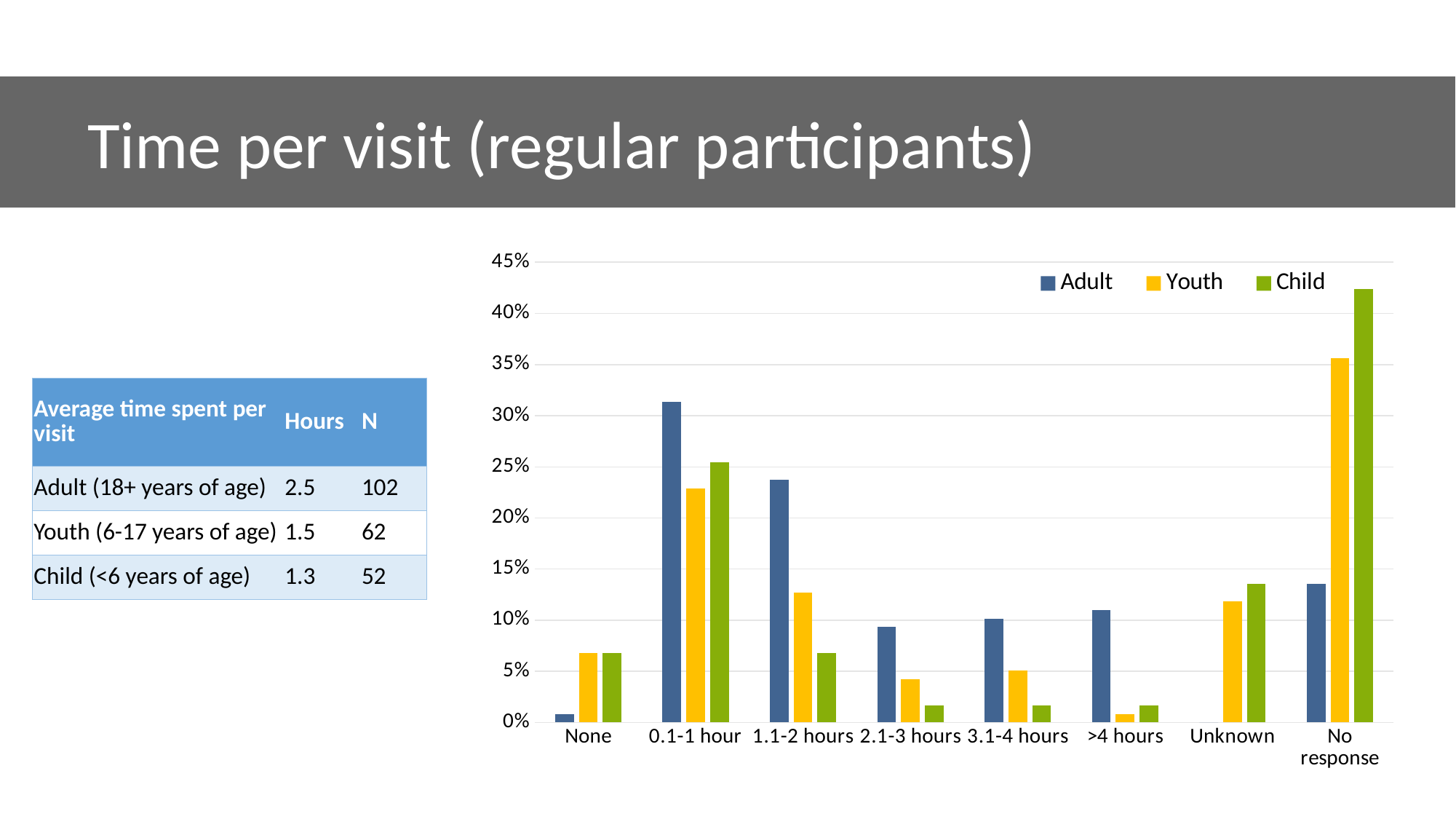
How many categories are shown along the x axis of the chart? 8 For the Adult series, which category has the highest value? 0.1-1 hour In the No response category, which series has the highest value? Child How many series does the chart legend list? 3 What colour represents the Youth series in the chart? yellow For the Child series, which category has the highest value? No response In the 1.1-2 hours category, which is larger: the Adult value or the Youth value? Adult Is the Adult value for 0.1-1 hour greater or less than 30%? greater What kind of chart is shown on the slide? bar chart Is the Adult value for 1.1-2 hours greater or less than 20%? greater Is the Child value for No response greater or less than 40%? greater